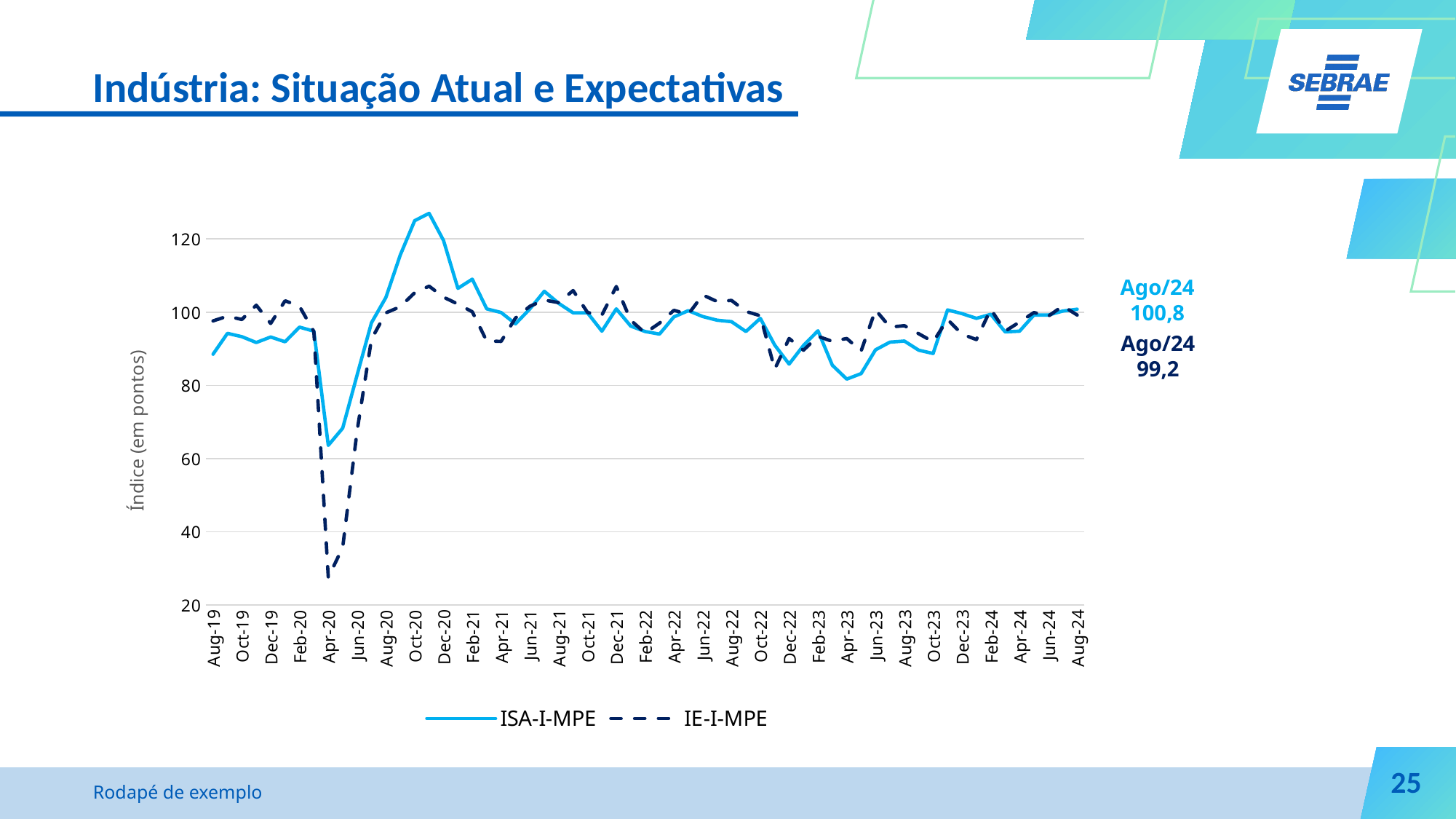
How many series does the legend list? 2 Which series reaches the lowest value anywhere on the chart? IE-I-MPE What is the value of IE-I-MPE in Ago/24? 99,2 Is the value of ISA-I-MPE in Apr-23 greater or less than 100? less What kind of chart is shown on the slide? line chart In Ago/24, which series has the higher value, ISA-I-MPE or IE-I-MPE? ISA-I-MPE What is the title of the vertical axis? Índice (em pontos) What is the value of ISA-I-MPE in Ago/24? 100,8 Is the value of IE-I-MPE in Apr-20 greater or less than 40? less Is the value of ISA-I-MPE in Apr-20 greater or less than 80? less What is the difference between the ISA-I-MPE and IE-I-MPE values in Ago/24? 1,6